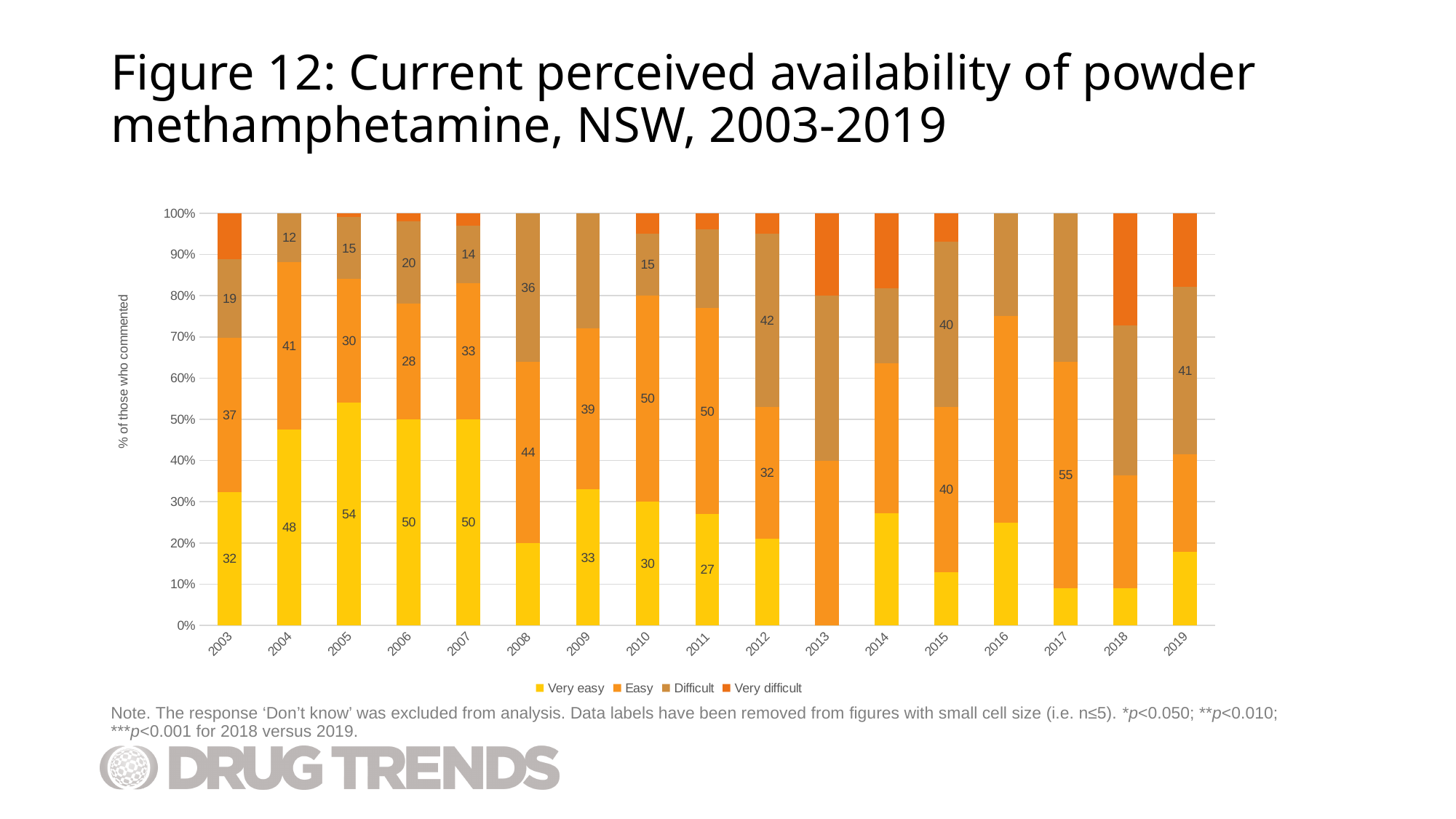
How many years are shown along the x axis? 17 What is the 'Very easy' value for 2005? 54 What is the difference between the 'Easy' and 'Very easy' values for 2003? 5 What is the 'Easy' value for 2017? 55 What kind of chart is shown on the slide? Stacked bar chart How many series does the legend list? 4 Is the 'Very easy' value for 2016 greater or less than 20%? greater Which year has the lowest 'Difficult' value? 2004 Which year has the highest 'Very easy' value? 2005 What is the 'Difficult' value for 2012? 42 What is the 'Difficult' value for 2019? 41 Which is larger, the 'Easy' value for 2010 or for 2004? 2010